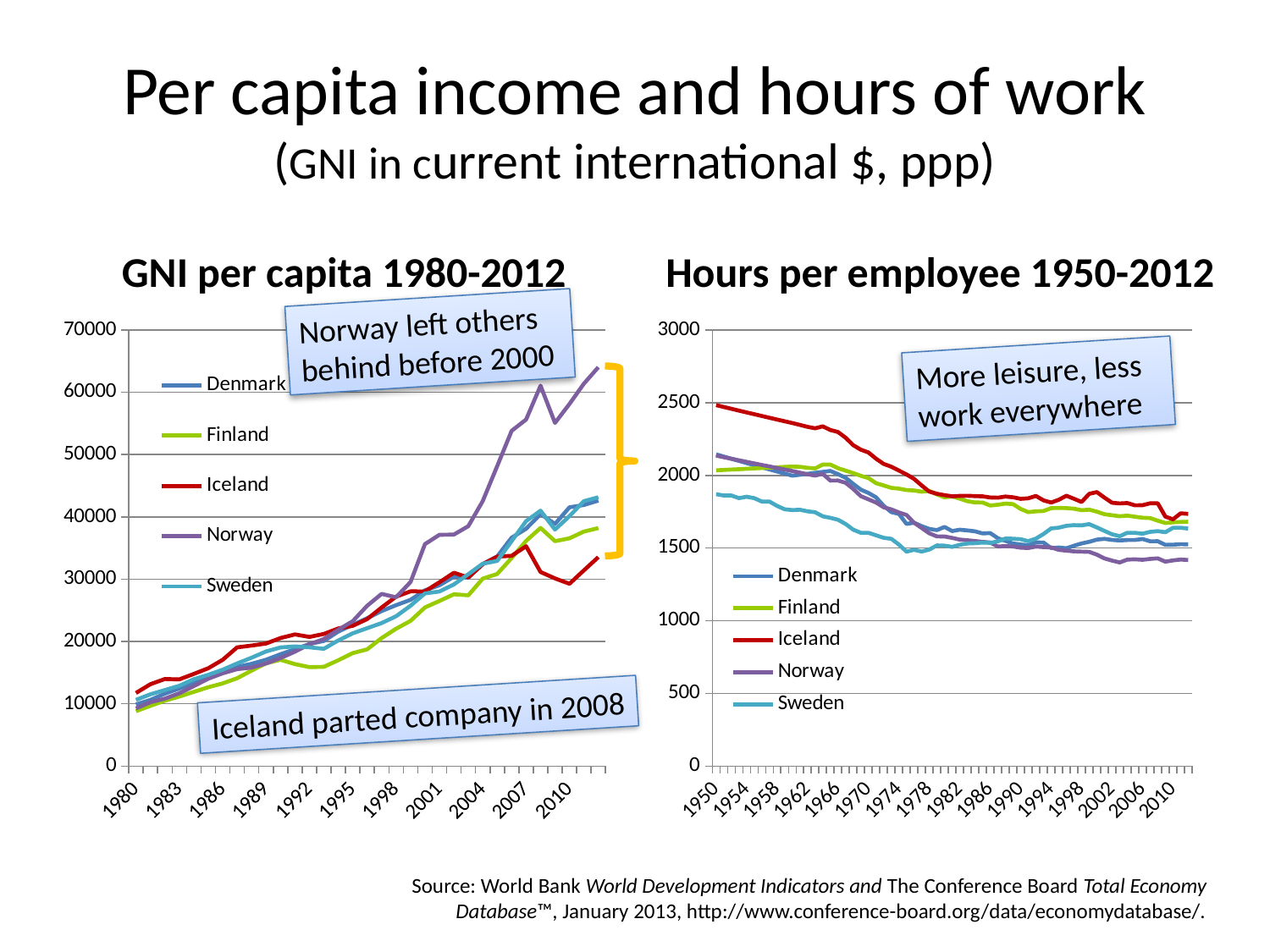
In the 'GNI per capita 1980-2012' chart, which country has the highest GNI per capita at the end of the period? Norway In the 'GNI per capita 1980-2012' chart, do the values generally rise or fall from 1980 to 2012? rise In the 'Hours per employee 1950-2012' chart, which country has the lowest hours per employee in 2012? Norway In the 'GNI per capita 1980-2012' chart, is Norway's value in 2012 greater or less than 60000? greater In the 'GNI per capita 1980-2012' chart, is Iceland's value in 2012 greater or less than 40000? less What kind of chart is the 'GNI per capita 1980-2012' chart? line chart In the 'GNI per capita 1980-2012' chart, which country has the lowest GNI per capita in 2012? Iceland In the 'Hours per employee 1950-2012' chart, is Iceland's value in 1950 greater or less than 2000? greater In the 'Hours per employee 1950-2012' chart, do hours per employee generally rise or fall from 1950 to 2012? fall In the 'GNI per capita 1980-2012' chart, which colour is used for the Norway line? purple In the 'Hours per employee 1950-2012' chart, which country has the highest hours per employee in 1950? Iceland How many series does the legend of the 'Hours per employee 1950-2012' chart list? 5